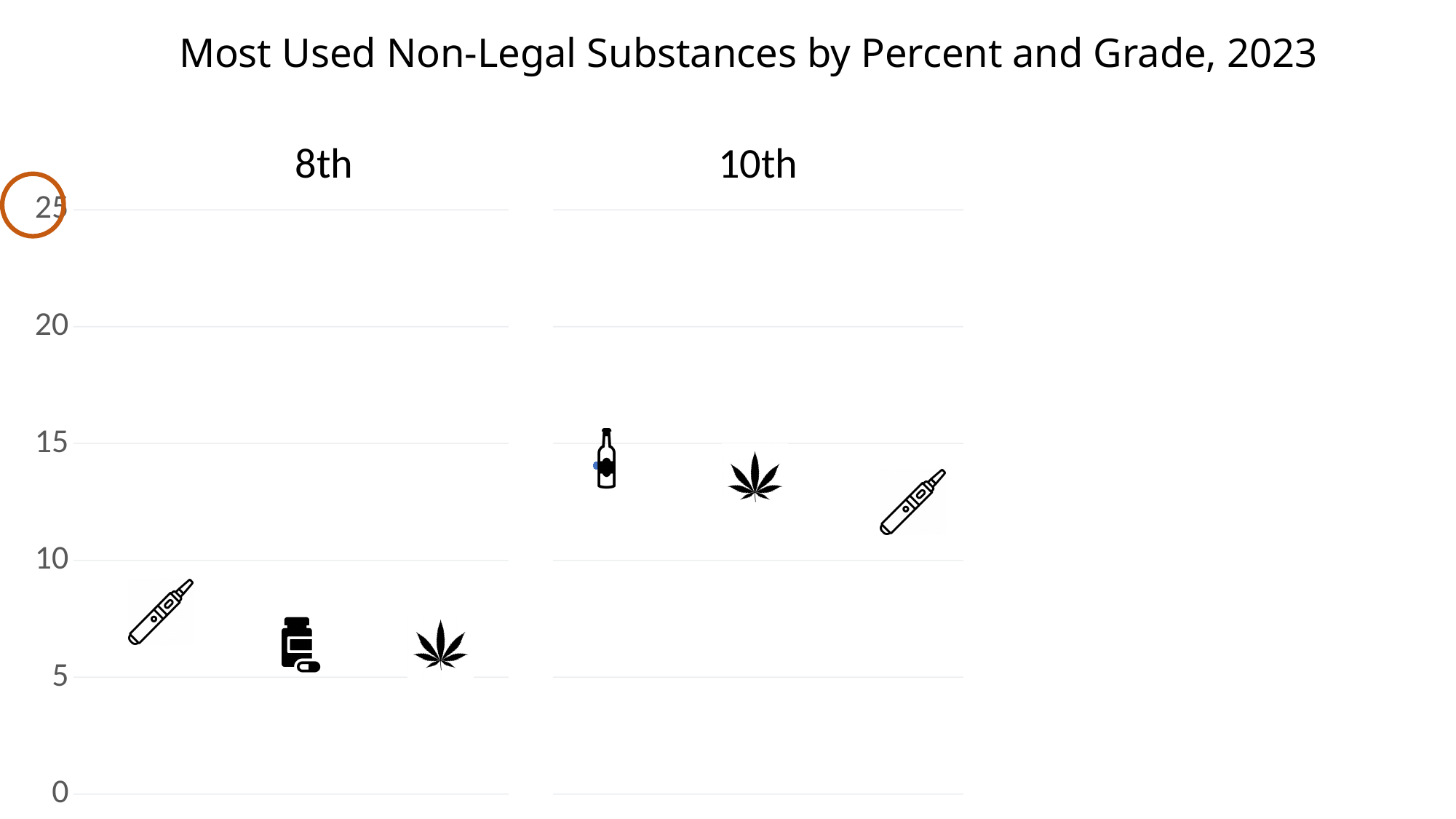
In the 8th grade panel, is the value for the cannabis leaf icon greater or less than 5? greater What is the title of the chart? Most Used Non-Legal Substances by Percent and Grade, 2023 In the 8th grade panel, is the value for the vape pen icon greater or less than 10? less How many substance icons are plotted in the 10th grade panel? 3 In the 8th grade panel, which substance icon is placed highest? the vape pen In the 10th grade panel, which substance icon is placed lowest? the vape pen Which two grades are shown as panels in the chart? 8th and 10th Is the cannabis leaf icon placed higher in the 8th grade panel or the 10th grade panel? 10th How many substance icons are plotted in the 8th grade panel? 3 In the 10th grade panel, is the value for the vape pen icon greater or less than 15? less Is the vape pen icon placed higher in the 8th grade panel or the 10th grade panel? 10th